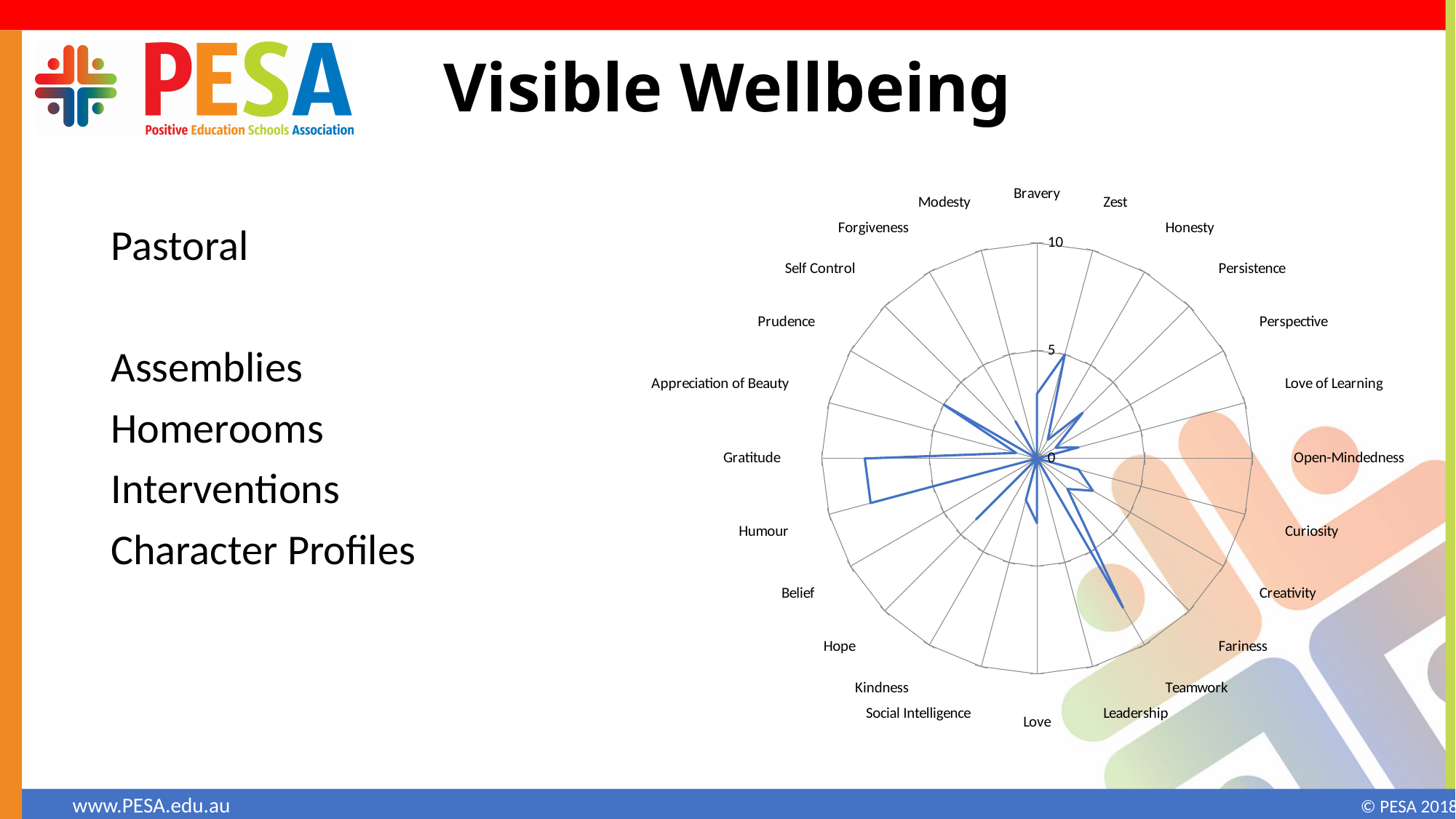
What kind of chart is shown on the slide? Radar chart Is the value for Love greater or less than 5? less What is the maximum value shown on the radar chart's axis scale? 10 How many character strengths (categories) are plotted on the radar chart? 24 Is the value for Curiosity greater or less than 5? less Is the value for Humour greater or less than 5? greater What colour is the data line plotted on the radar chart? Blue Which is larger, the value for Teamwork or the value for Curiosity? Teamwork